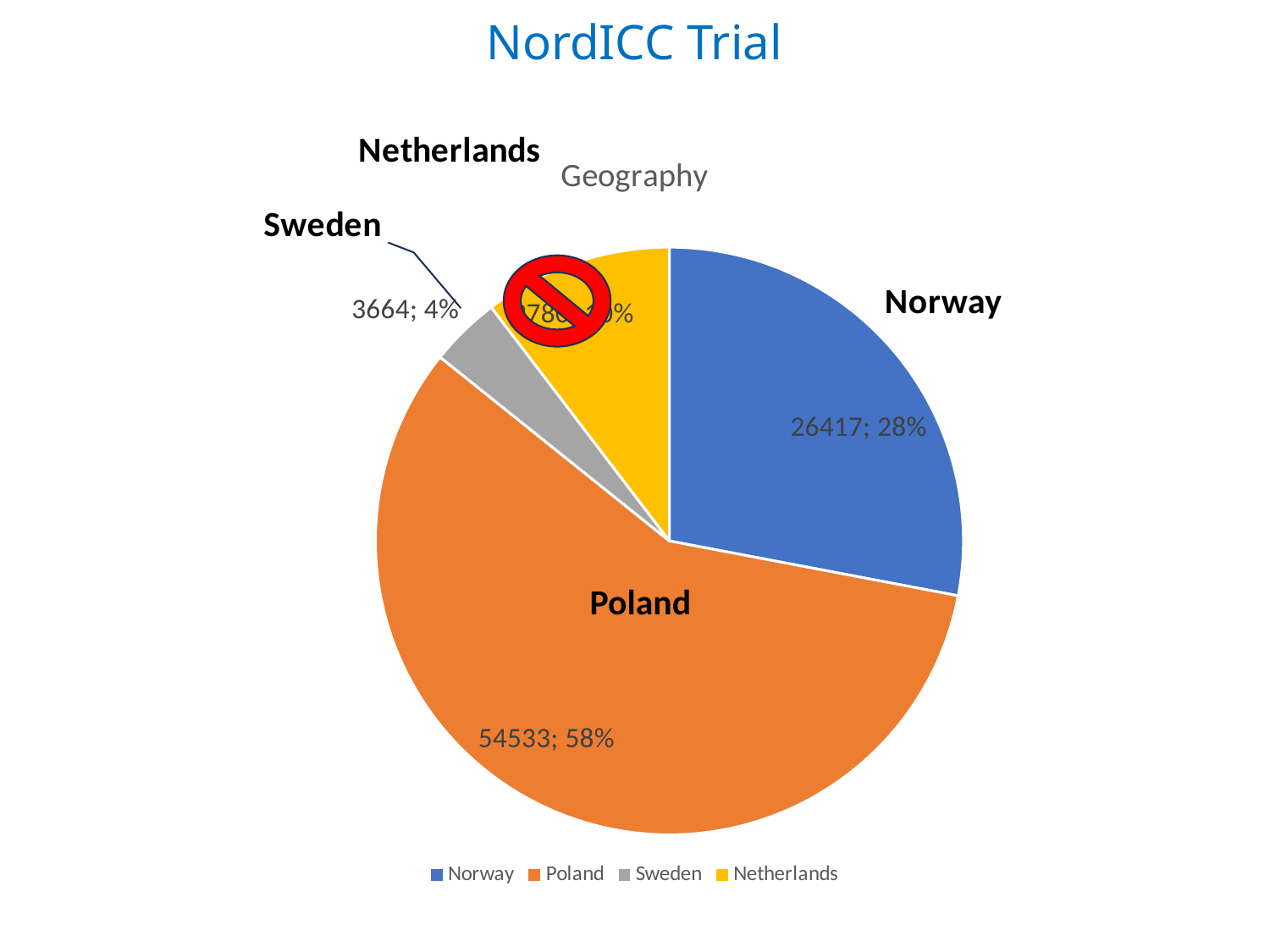
What is the difference between the values for Poland and Norway? 28116 What kind of chart is shown on the slide? pie chart What value is shown for Sweden? 3664 How many entries does the legend list? 4 Which country has the largest slice? Poland What share of the pie does Poland represent? 58% How many slices does the pie chart have? 4 What is the title of the chart? Geography Which country has the smallest slice? Sweden What value is shown for Norway? 26417 What value is shown for Poland? 54533 What share of the pie does Norway represent? 28%